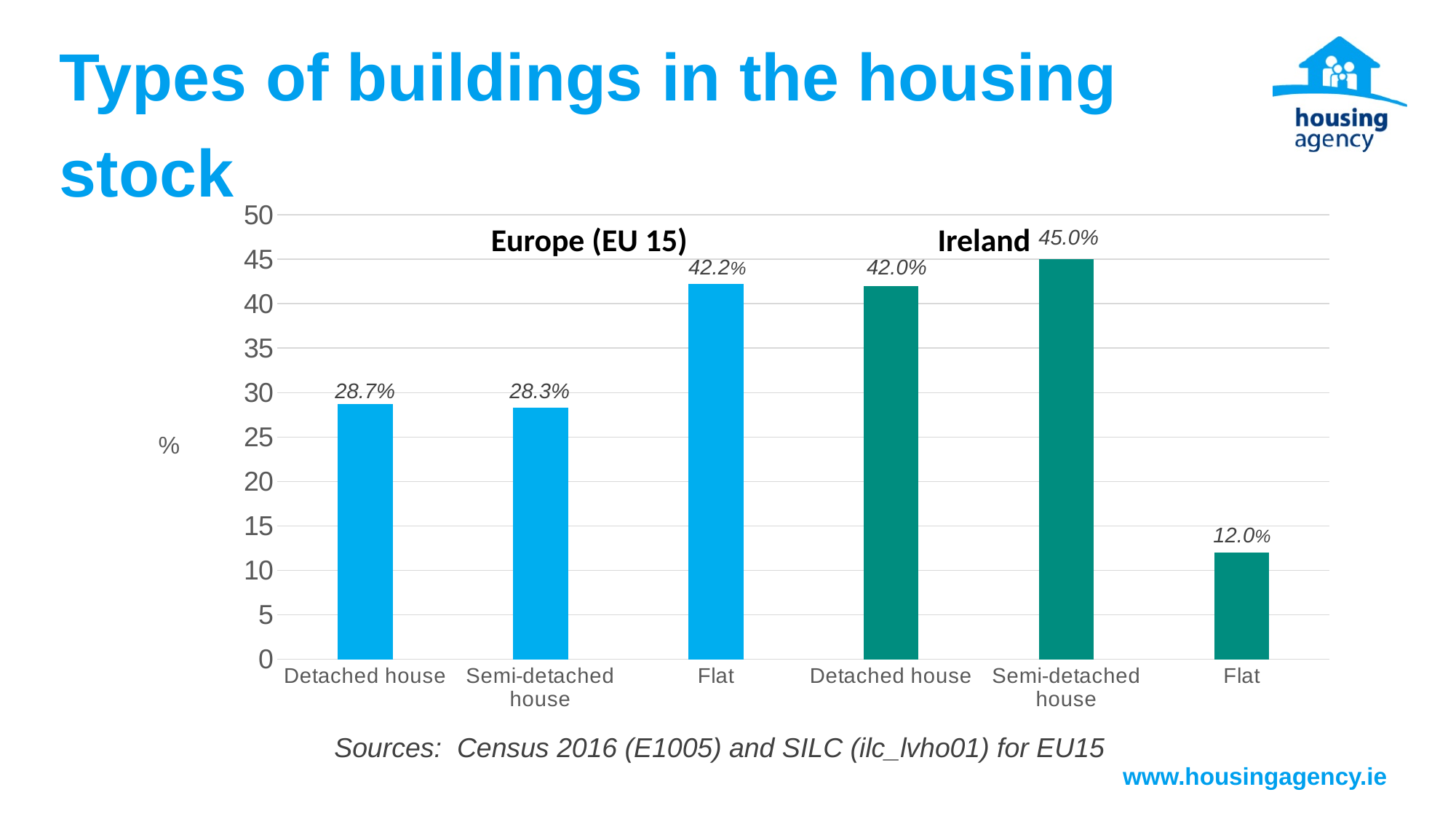
Which is larger: Detached house in Europe (EU 15) or Detached house in Ireland? Detached house in Ireland What is the value for Flat in Ireland? 12.0% What is the value for Flat in Europe (EU 15)? 42.2% How many bars are plotted on the chart? 6 What is the label on the vertical axis of the chart? % What is the value for Semi-detached house in Ireland? 45.0% Is the value for Semi-detached house in Europe (EU 15) greater or less than 30? less Which bar has the lowest value on the chart? Flat (Ireland) Which bar has the highest value on the chart? Semi-detached house (Ireland) What is the value for Detached house in Europe (EU 15)? 28.7% What is the difference between the Flat value for Europe (EU 15) and the Flat value for Ireland? 30.2% What kind of chart is shown on the slide? Bar chart